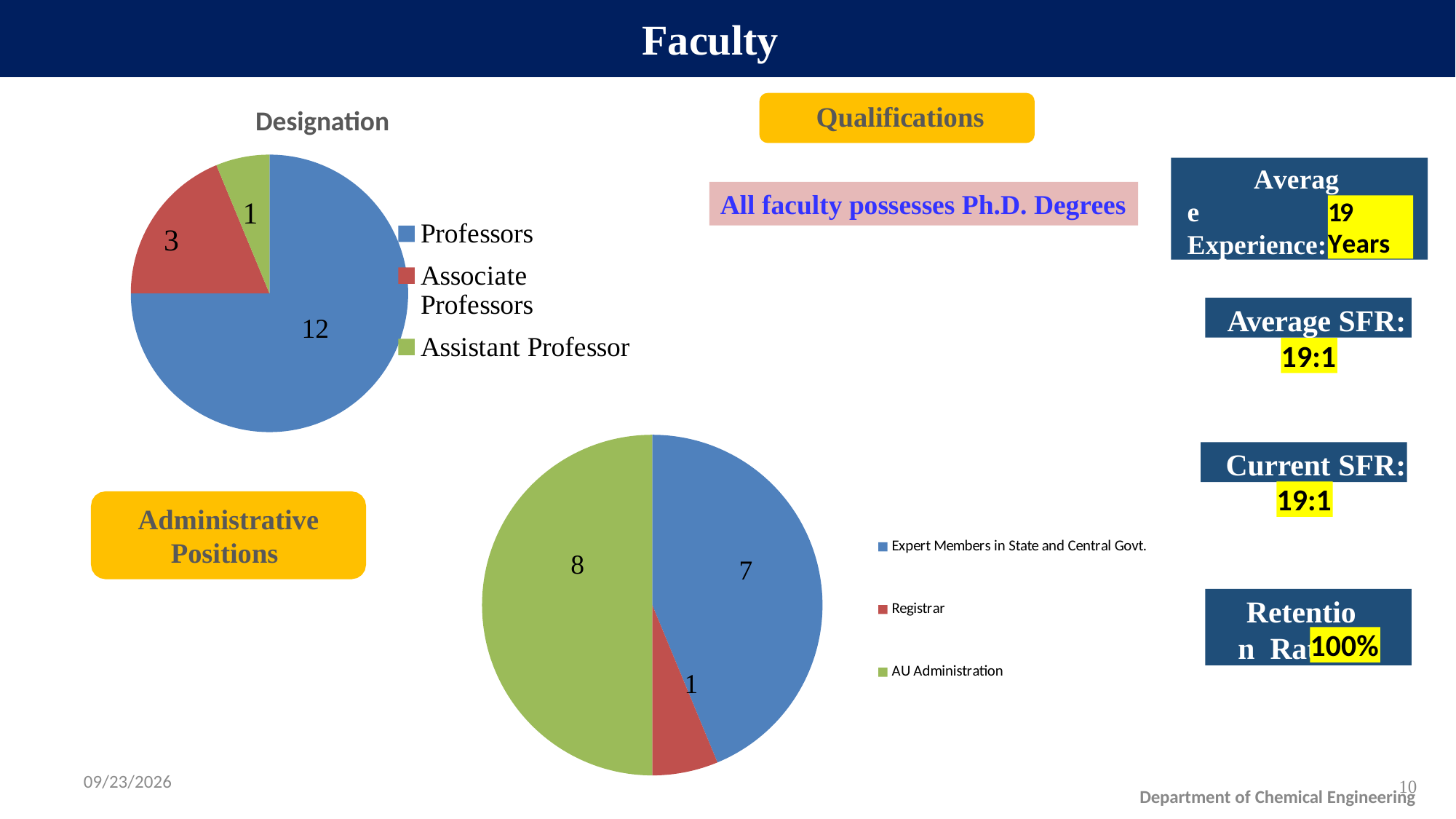
How many categories does the Designation pie chart show? 3 In the lower pie chart next to Administrative Positions, what share of the pie does AU Administration represent? 50% In the lower pie chart next to Administrative Positions, which category has the smallest slice? Registrar In the lower pie chart next to Administrative Positions, what is the value for AU Administration? 8 In the Designation pie chart, what share of the pie do Professors represent? 75% In the Designation pie chart, what is the value for Professors? 12 In the lower pie chart next to Administrative Positions, what colour is the Registrar slice? Red What kind of chart is the Designation chart? Pie chart In the Designation pie chart, what is the value for Associate Professors? 3 In the lower pie chart next to Administrative Positions, what is the value for Expert Members in State and Central Govt.? 7 In the Designation pie chart, what is the difference between Professors and Associate Professors? 9 In the Designation pie chart, which category has the smallest slice? Assistant Professor